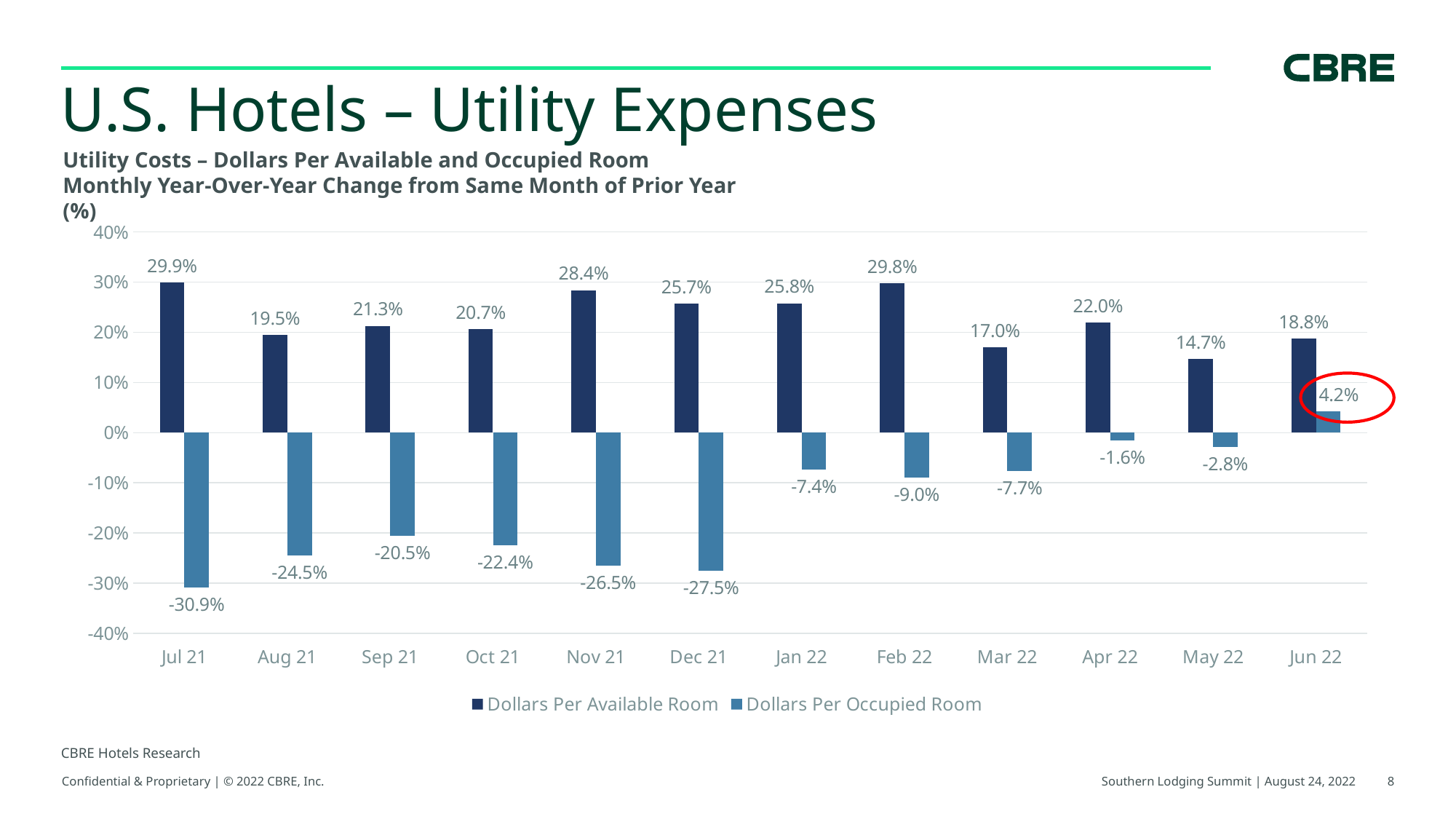
What is the value for Dollars Per Occupied Room in Dec 21? -27.5% What is the value for Dollars Per Occupied Room in Jun 22? 4.2% Which month has the lowest value for Dollars Per Occupied Room? Jul 21 What is the value for Dollars Per Available Room in Jul 21? 29.9% Which month has the highest value for Dollars Per Available Room? Jul 21 Which series is shown in the lighter blue colour? Dollars Per Occupied Room How many months are shown on the x axis? 12 Which month has the lowest value for Dollars Per Available Room? May 22 What kind of chart is shown on the slide? Bar chart How many series does the legend list? 2 What is the difference between the Dollars Per Available Room values for Feb 22 and Mar 22? 12.8% Which is larger: Dollars Per Available Room in Nov 21 or in Dec 21? Nov 21